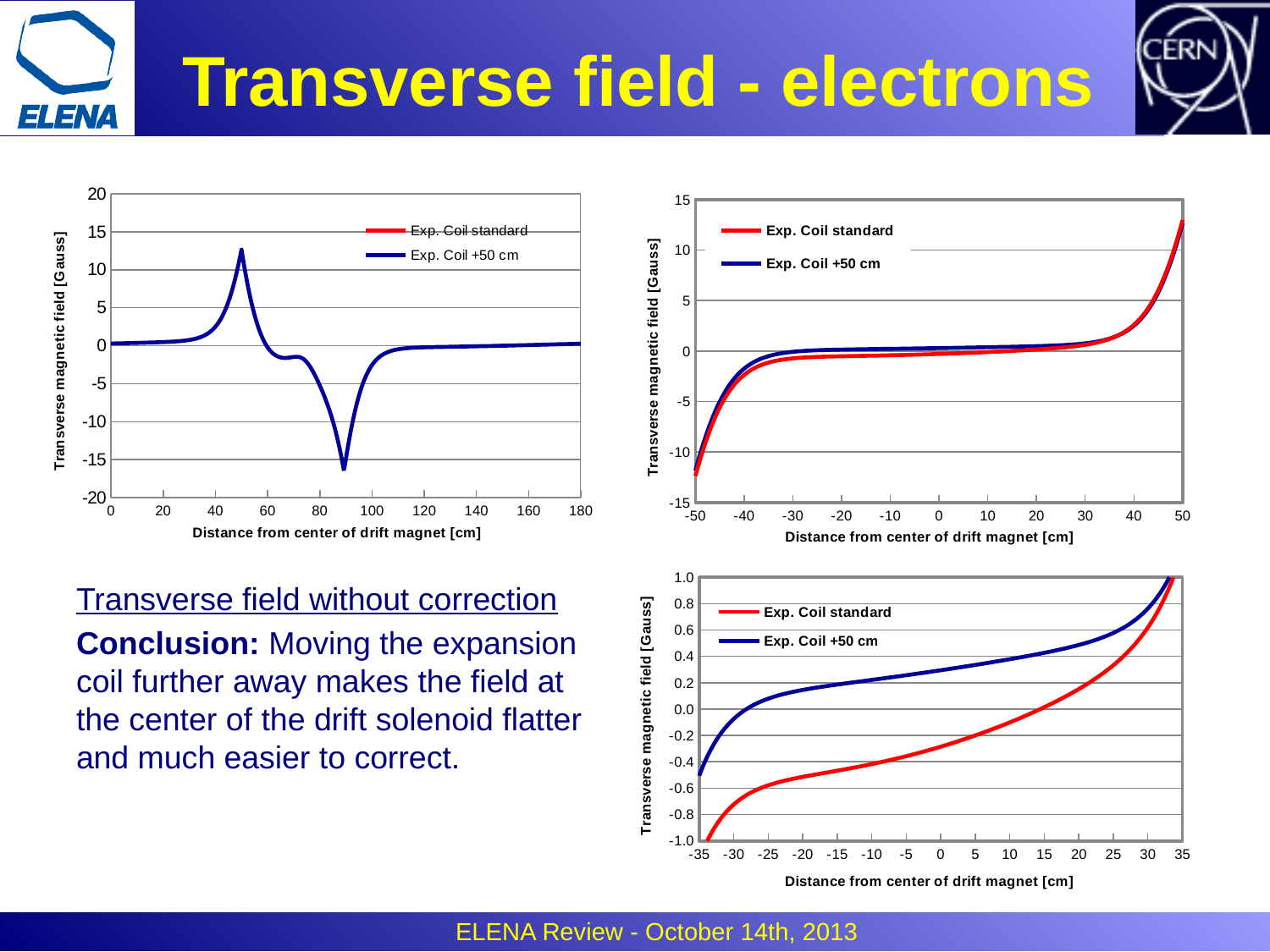
In the bottom-right chart, which series has the higher value at a distance of 0 cm, Exp. Coil standard or Exp. Coil +50 cm? Exp. Coil +50 cm What is the x-axis title of the top-right chart? Distance from center of drift magnet [cm] In the top-right chart, is the value of Exp. Coil standard at a distance of -50 cm greater or less than -10 Gauss? less In the bottom-right chart, do the values of Exp. Coil +50 cm rise or fall as the distance increases from -35 cm to 35 cm? rise How many series does the legend of the bottom-right chart list? 2 What kind of chart is the top-left chart on the slide? line chart In the bottom-right chart, is the value of Exp. Coil standard at a distance of 0 cm greater or less than 0 Gauss? less In the top-left chart, is the value at a distance of 90 cm greater or less than -10 Gauss? less In the top-left chart, what are the two series named in the legend? Exp. Coil standard and Exp. Coil +50 cm How many series does the legend of the top-left chart list? 2